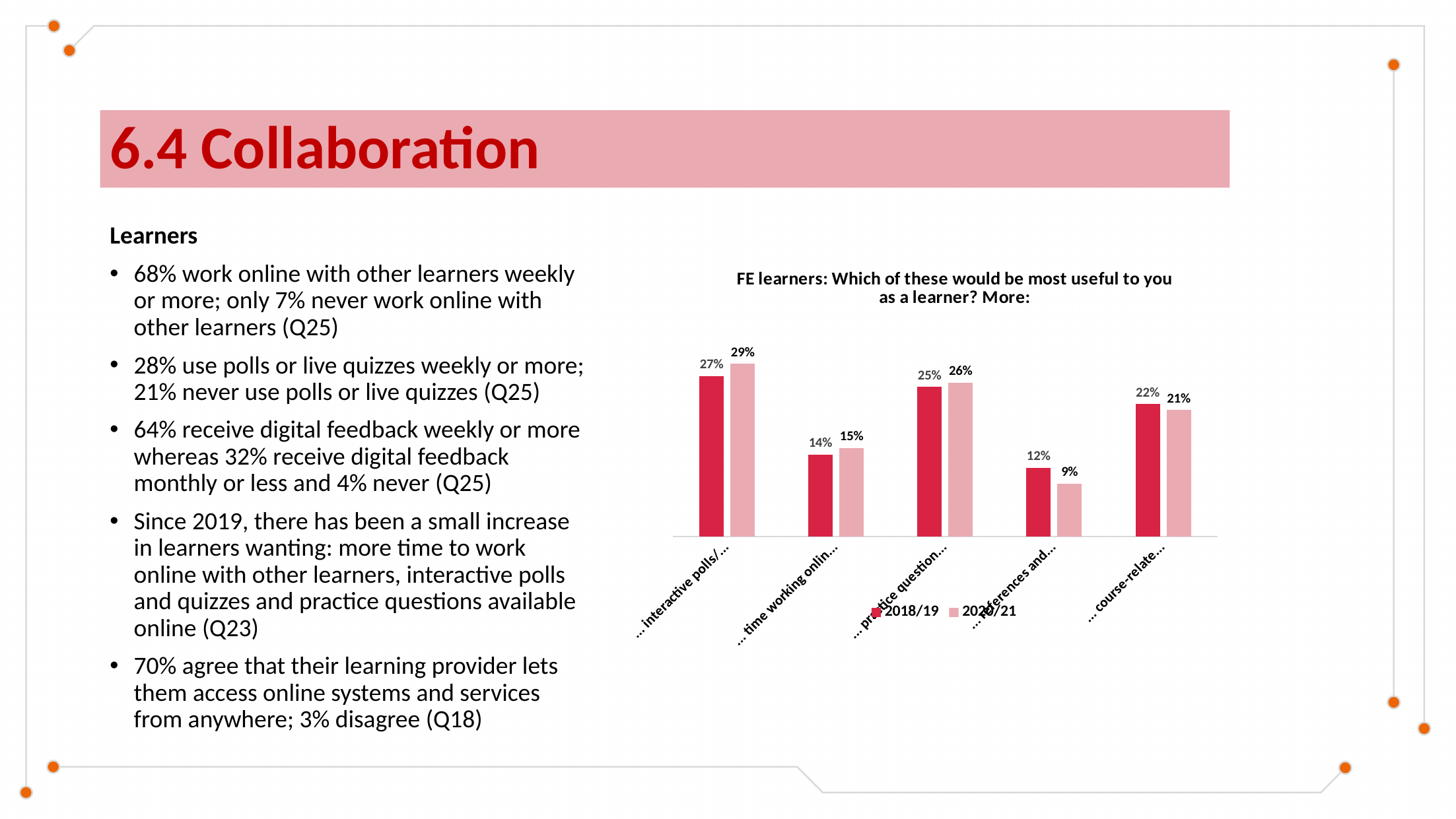
What is the 2020/21 value for the "interactive polls" category? 29% For the "course-relate..." category, which is larger: the 2018/19 value or the 2020/21 value? 2018/19 What is the 2018/19 value for the "references and..." category? 12% Which category has the lowest 2020/21 value? ... references and... What is the 2020/21 value for the "practice question..." category? 26% What is the difference between the 2018/19 and 2020/21 values for the "references and..." category? 3% How many categories are shown on the x axis of the chart? 5 Which series is shown in the lighter pink colour? 2020/21 What is the 2018/19 value for the "interactive polls" category? 27% How many series does the chart legend list? 2 What type of chart is shown on the slide? Bar chart Which category has the highest 2020/21 value? ... interactive polls/...